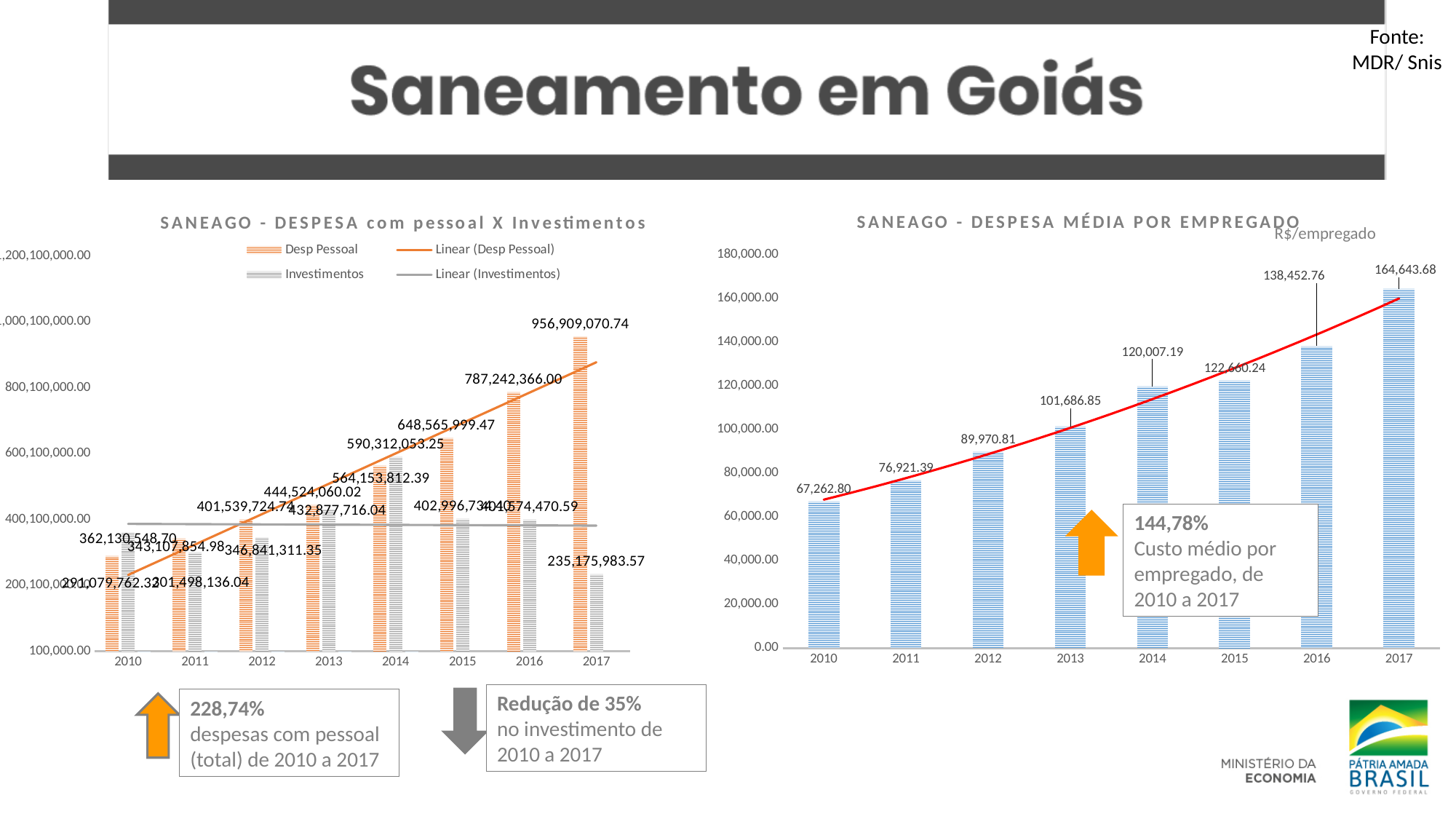
In the chart 'SANEAGO - DESPESA com pessoal X Investimentos', what is the Investimentos value for 2017? 235,175,983.57 How many years are shown on the x axis of the chart 'SANEAGO - DESPESA MÉDIA POR EMPREGADO'? 8 In the chart 'SANEAGO - DESPESA MÉDIA POR EMPREGADO', what is the value for 2017? 164,643.68 In the chart 'SANEAGO - DESPESA com pessoal X Investimentos', which year has the highest Desp Pessoal value? 2017 In the chart 'SANEAGO - DESPESA MÉDIA POR EMPREGADO', what is the difference between the 2017 and 2010 values? 97,380.88 In the chart 'SANEAGO - DESPESA com pessoal X Investimentos', what is the Desp Pessoal value for 2017? 956,909,070.74 In the chart 'SANEAGO - DESPESA MÉDIA POR EMPREGADO', what is the value for 2010? 67,262.80 In the chart 'SANEAGO - DESPESA MÉDIA POR EMPREGADO', do the values rise or fall from 2010 to 2017? rise In the chart 'SANEAGO - DESPESA com pessoal X Investimentos', what is the difference between Desp Pessoal and Investimentos in 2017? 721,733,087.17 In the chart 'SANEAGO - DESPESA MÉDIA POR EMPREGADO', which year has the lowest value? 2010 In the chart 'SANEAGO - DESPESA com pessoal X Investimentos', which is larger in 2011: Desp Pessoal or Investimentos? Desp Pessoal How many entries does the legend of the chart 'SANEAGO - DESPESA com pessoal X Investimentos' list? 4